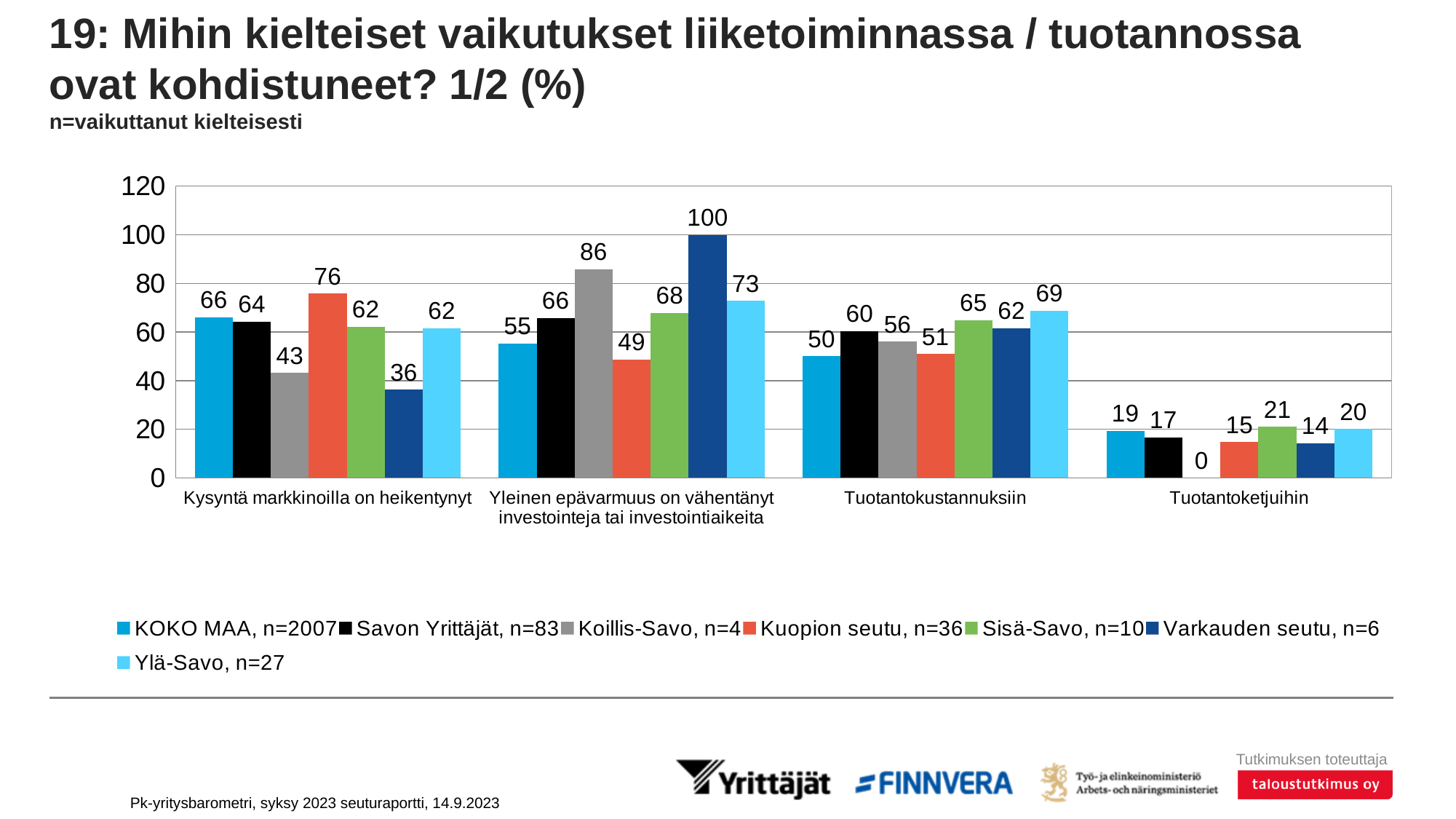
What is the value for Koillis-Savo in the category "Tuotantoketjuihin"? 0 What is the value for Varkauden seutu in the category "Yleinen epävarmuus on vähentänyt investointeja tai investointiaikeita"? 100 How many series does the legend list? 7 How many categories are shown on the x axis? 4 What is the value for Kuopion seutu in the category "Kysyntä markkinoilla on heikentynyt"? 76 What is the value for Ylä-Savo in the category "Tuotantokustannuksiin"? 69 Which series has the highest value in the category "Yleinen epävarmuus on vähentänyt investointeja tai investointiaikeita"? Varkauden seutu, n=6 Which series has the lowest value in the category "Kysyntä markkinoilla on heikentynyt"? Varkauden seutu, n=6 What is the difference between the Koillis-Savo value and the Kuopion seutu value in the category "Yleinen epävarmuus on vähentänyt investointeja tai investointiaikeita"? 37 What is the sample size (n) given in the legend for Savon Yrittäjät? 83 What kind of chart is shown on the slide? Bar chart In the category "Tuotantokustannuksiin", which is larger: the value for Savon Yrittäjät or the value for KOKO MAA? Savon Yrittäjät